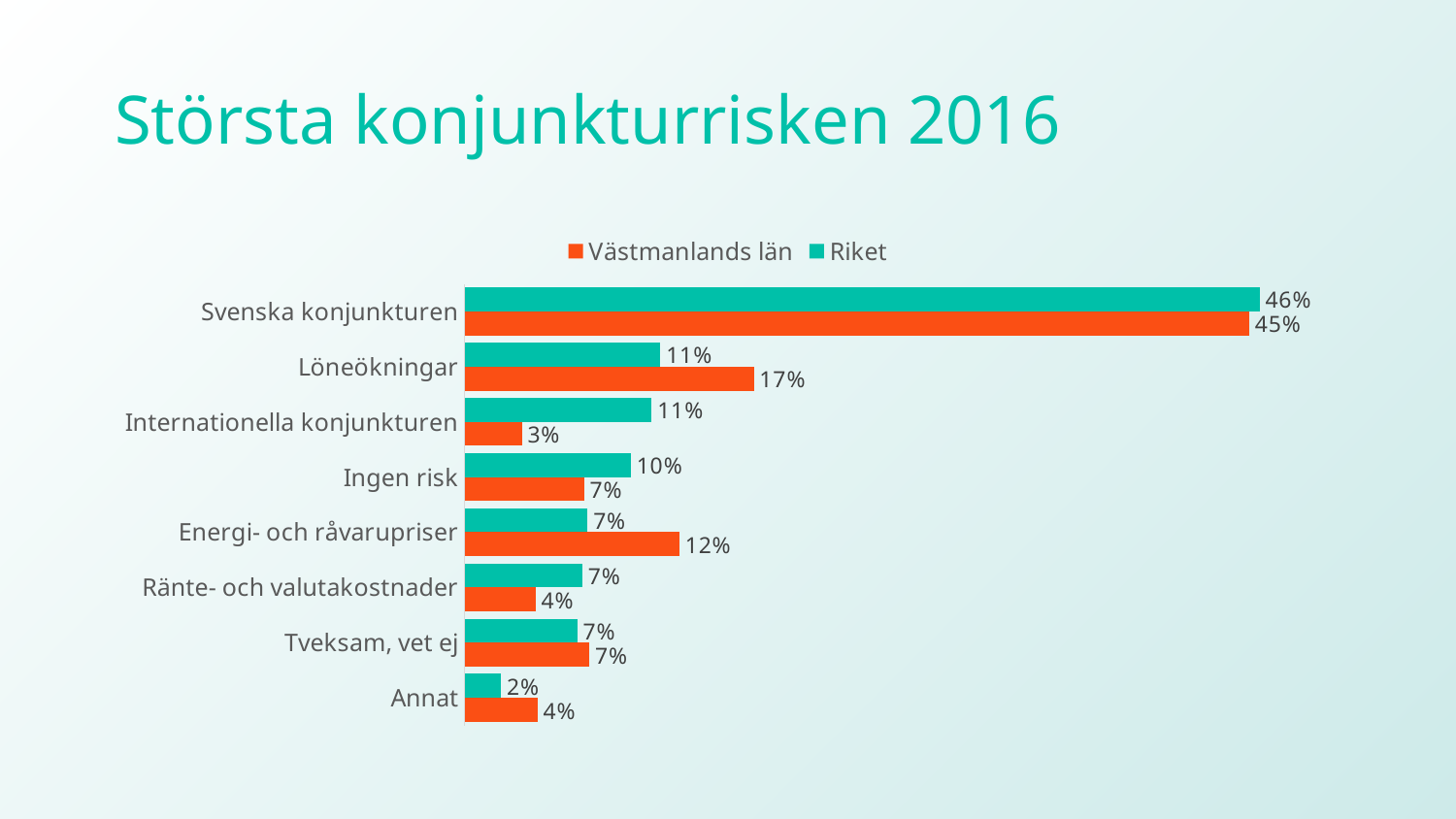
How many series does the legend list? 2 What is the value for Västmanlands län for Internationella konjunkturen? 3% What is the value for Västmanlands län for Löneökningar? 17% For Energi- och råvarupriser, which series has the larger value, Västmanlands län or Riket? Västmanlands län What is the value for Riket for Annat? 2% Which category has the lowest value for Riket? Annat What is the difference between the Västmanlands län and Riket values for Löneökningar? 6% What is the title of the slide? Största konjunkturrisken 2016 What kind of chart is shown on the slide? Bar chart What is the value for Riket for Svenska konjunkturen? 46% Which category has the highest value for Västmanlands län? Svenska konjunkturen How many categories are shown in the chart? 8